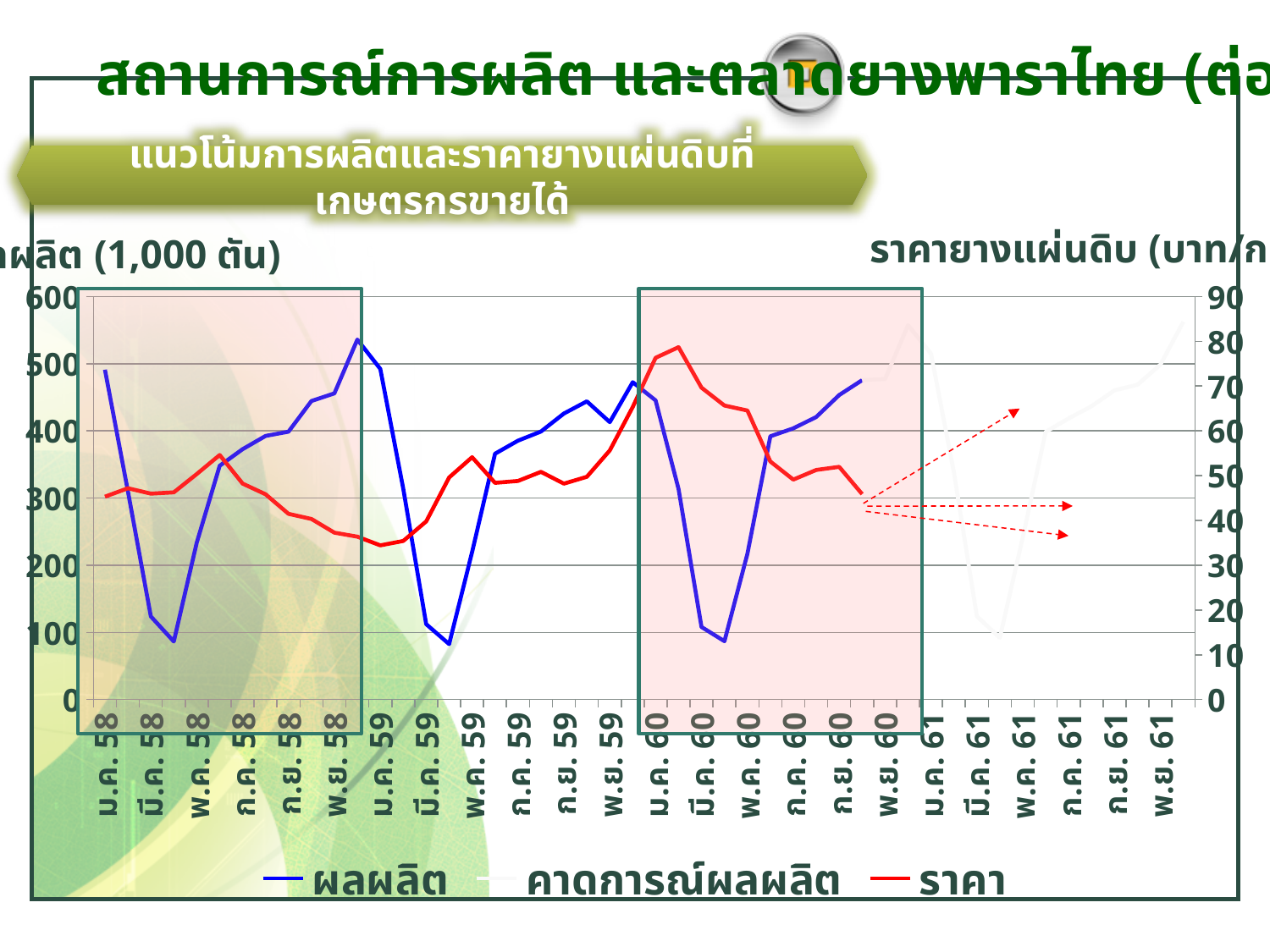
What is the title of the left vertical axis of the chart? ผลผลิต (1,000 ตัน) Is the ผลผลิต value at ม.ค. 58 greater or less than 400? greater Is the ราคา value at ม.ค. 59 greater or less than 40? less How many month labels are shown along the x axis of the chart? 24 What kind of chart is shown on the slide? line chart How many series does the chart legend list? 3 What are the three series named in the chart legend? ผลผลิต, คาดการณ์ผลผลิต, ราคา Does the ผลผลิต line rise or fall between มี.ค. 60 and ก.ย. 60? rise Is the ผลผลิต value at มี.ค. 60 greater or less than 200? less Which is larger, the ผลผลิต value at ม.ค. 58 or at มี.ค. 58? ม.ค. 58 Does the ราคา line rise or fall between ม.ค. 60 and ก.ย. 60? fall